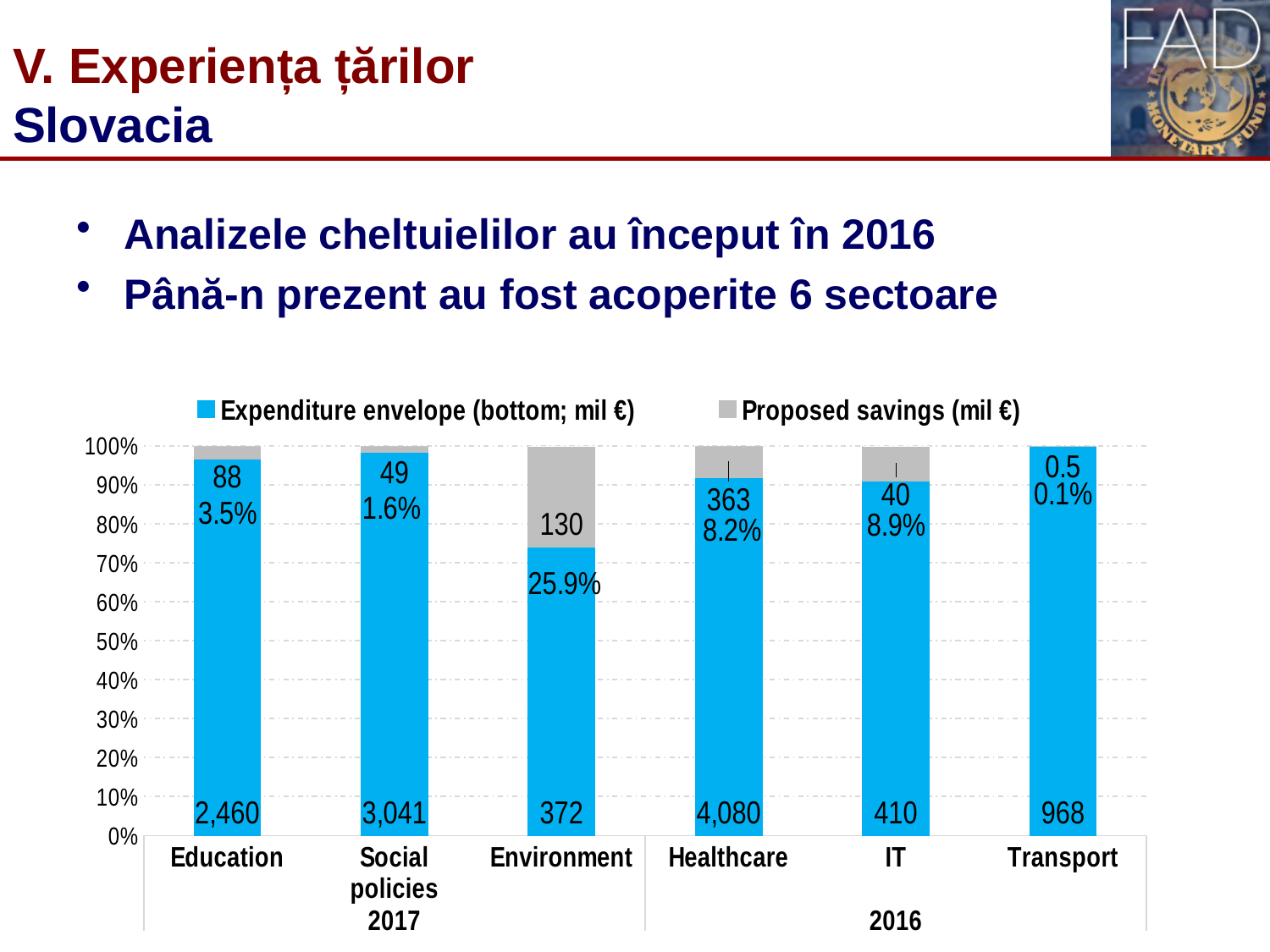
What percentage is shown for the Transport bar? 0.1% How many categories are shown on the x axis of the chart? 6 What proposed savings value is shown for Environment? 130 What is the expenditure envelope value shown for Healthcare? 4,080 Which category has the lowest proposed savings value? Transport Which category has the highest expenditure envelope value? Healthcare What is the difference between the expenditure envelope values for Healthcare and Social policies? 1,039 Which has a larger expenditure envelope value, Education or Transport? Education Which category has the lowest expenditure envelope value? Environment Is the blue expenditure envelope portion of the Environment bar greater or less than 80%? less How many series does the chart legend list? 2 What kind of chart is shown on the slide? Stacked bar chart